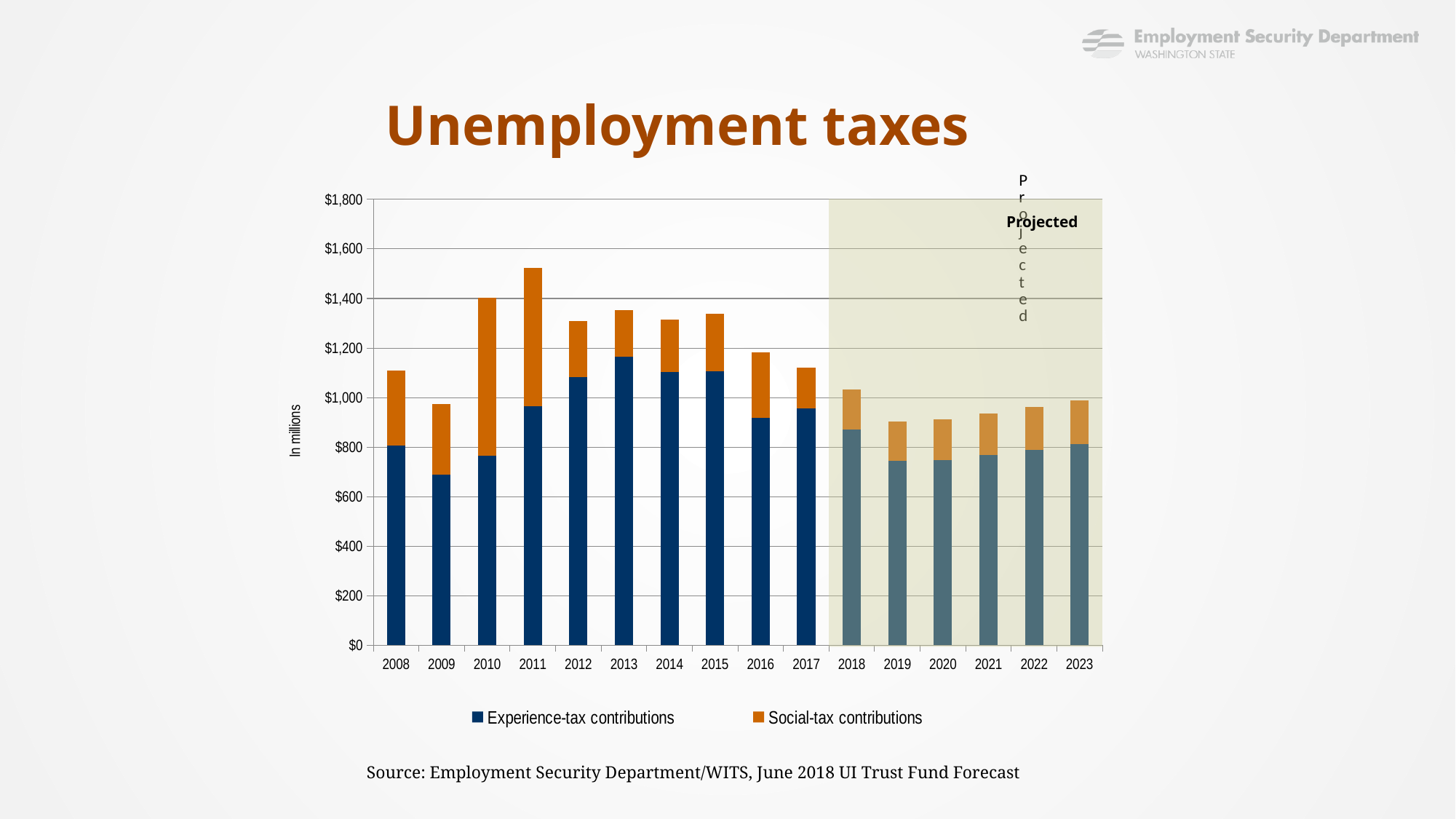
Which year has the larger total, 2009 or 2010? 2010 Which year has the highest total unemployment tax contributions? 2011 How many series does the chart's legend list? 2 Do the total contributions rise or fall from 2019 to 2023? rise Is the total for 2019 greater or less than $1,000? less Is the total for 2011 greater or less than $1,400? greater What kind of chart is shown on the slide? Stacked bar chart What label is shown on the shaded region covering 2018 to 2023? Projected Is the Experience-tax contributions value for 2009 greater or less than $800? less What are the two series named in the legend? Experience-tax contributions and Social-tax contributions How many years are shown along the x axis of the chart? 16